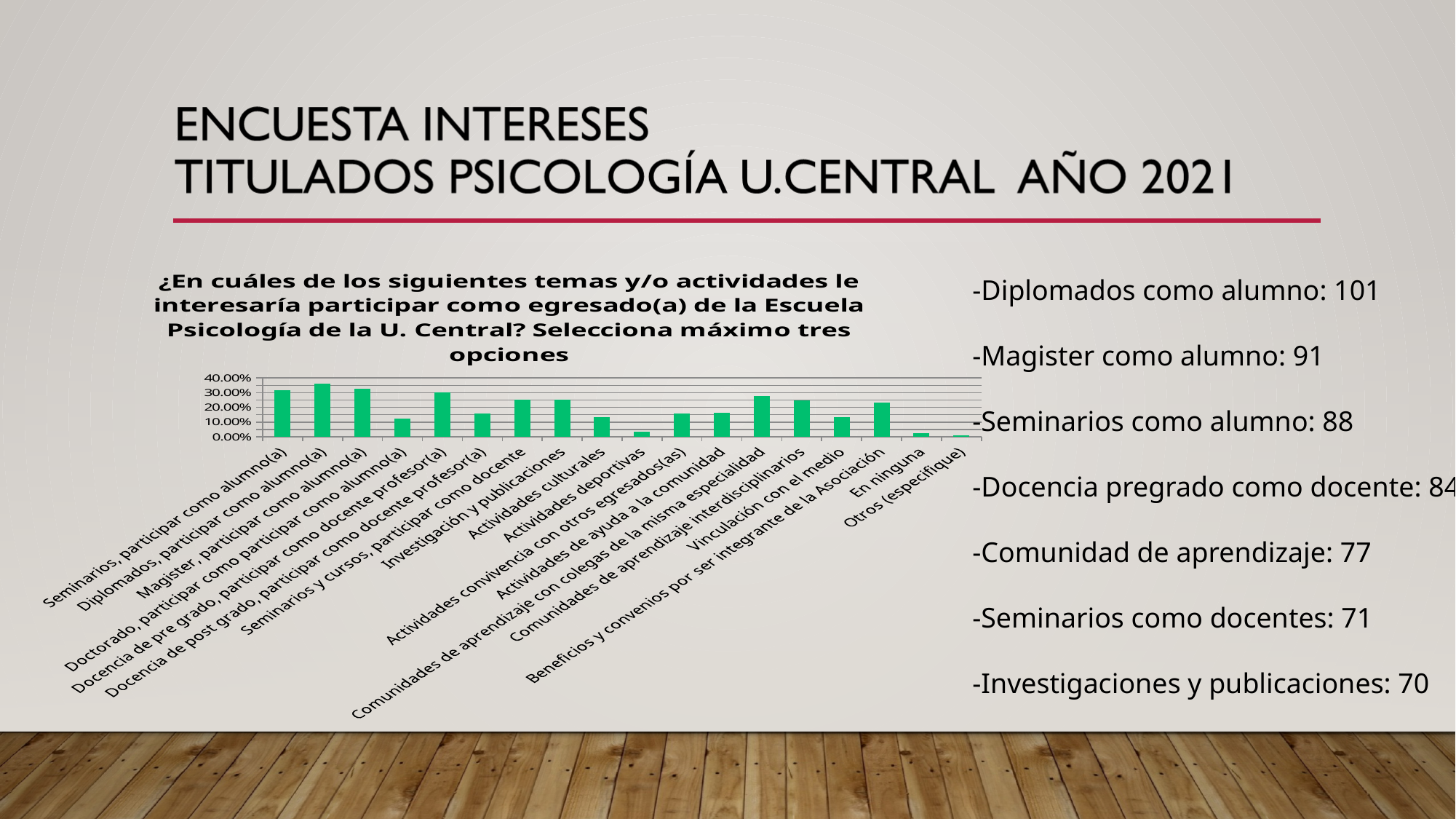
Is the value for "Actividades deportivas" greater or less than 10.00%? less Is the value for "Investigación y publicaciones" greater or less than 20.00%? greater Which is larger: the value for "Diplomados, participar como alumno(a)" or for "Doctorado, participar como alumno(a)"? Diplomados, participar como alumno(a) How many categories (bars) does the chart show? 18 Which is larger: the value for "Actividades culturales" or for "Actividades deportivas"? Actividades culturales What kind of chart is shown on the slide? bar chart Which category has the highest bar in the chart? Diplomados, participar como alumno(a) Is the value for "Vinculación con el medio" greater or less than 20.00%? less What is the highest value shown on the chart's vertical axis? 40.00%